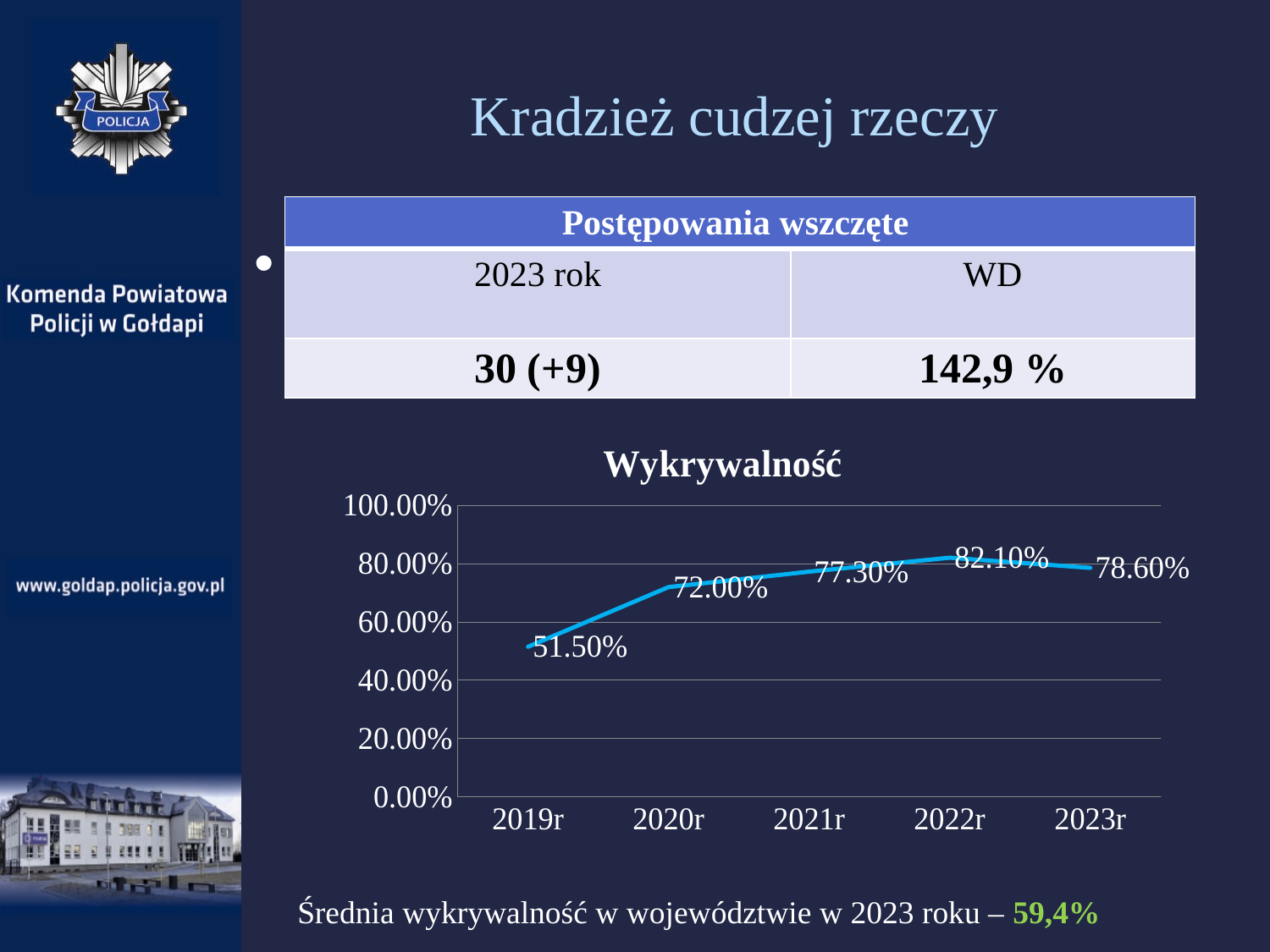
Which is larger, the value for 2020r or the value for 2021r? 2021r Is the value for 2019r greater or less than 60.00%? less What kind of chart is shown on the slide? line chart Which year has the lowest detection rate on the chart? 2019r What is the detection rate (Wykrywalność) shown for 2019r? 51.50% What is the value plotted for 2023r? 78.60% Which year has the highest detection rate on the chart? 2022r What is the title of the chart? Wykrywalność How many years are plotted on the chart? 5 By how much did the detection rate change from 2019r to 2020r? 20.50% What value does the chart show for 2021r? 77.30% What is the difference between the values for 2022r and 2023r? 3.50%